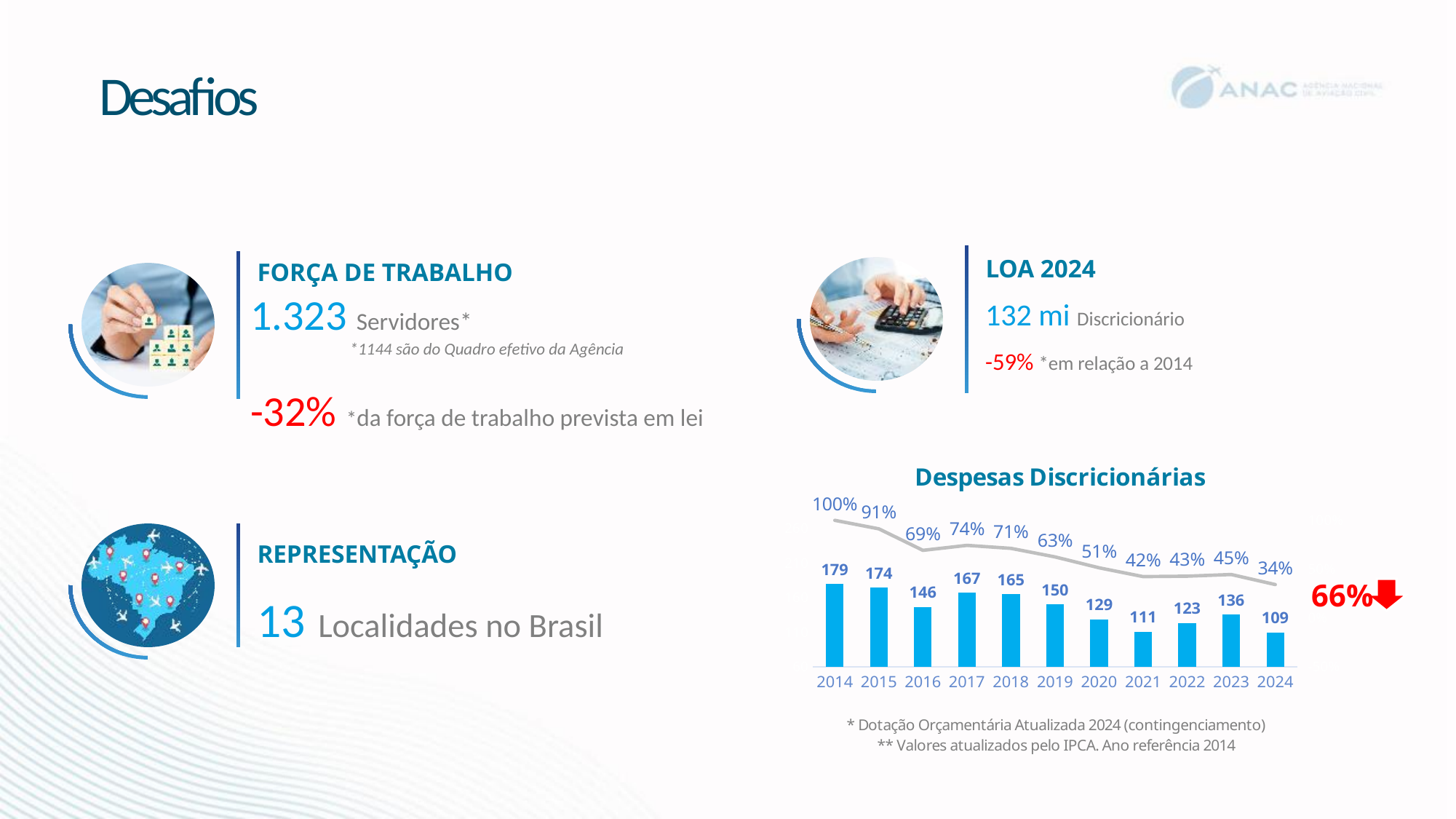
What is the difference between the bar values for 2014 and 2024 in the Despesas Discricionárias chart? 70 What is the bar value for 2014 in the Despesas Discricionárias chart? 179 In the Despesas Discricionárias chart, which year has a larger bar value, 2017 or 2023? 2017 What is the bar value for 2024 in the Despesas Discricionárias chart? 109 Do the bar values in the Despesas Discricionárias chart generally rise or fall from 2014 to 2024? Fall What percentage is shown on the line for 2019 in the Despesas Discricionárias chart? 63% What is the title of the chart on the slide? Despesas Discricionárias Which year has the highest bar in the Despesas Discricionárias chart? 2014 Which year has the lowest bar in the Despesas Discricionárias chart? 2024 What kind of chart is the Despesas Discricionárias chart? Bar chart with a line overlay How many years are shown on the x axis of the Despesas Discricionárias chart? 11 What percentage is shown on the line for 2021 in the Despesas Discricionárias chart? 42%